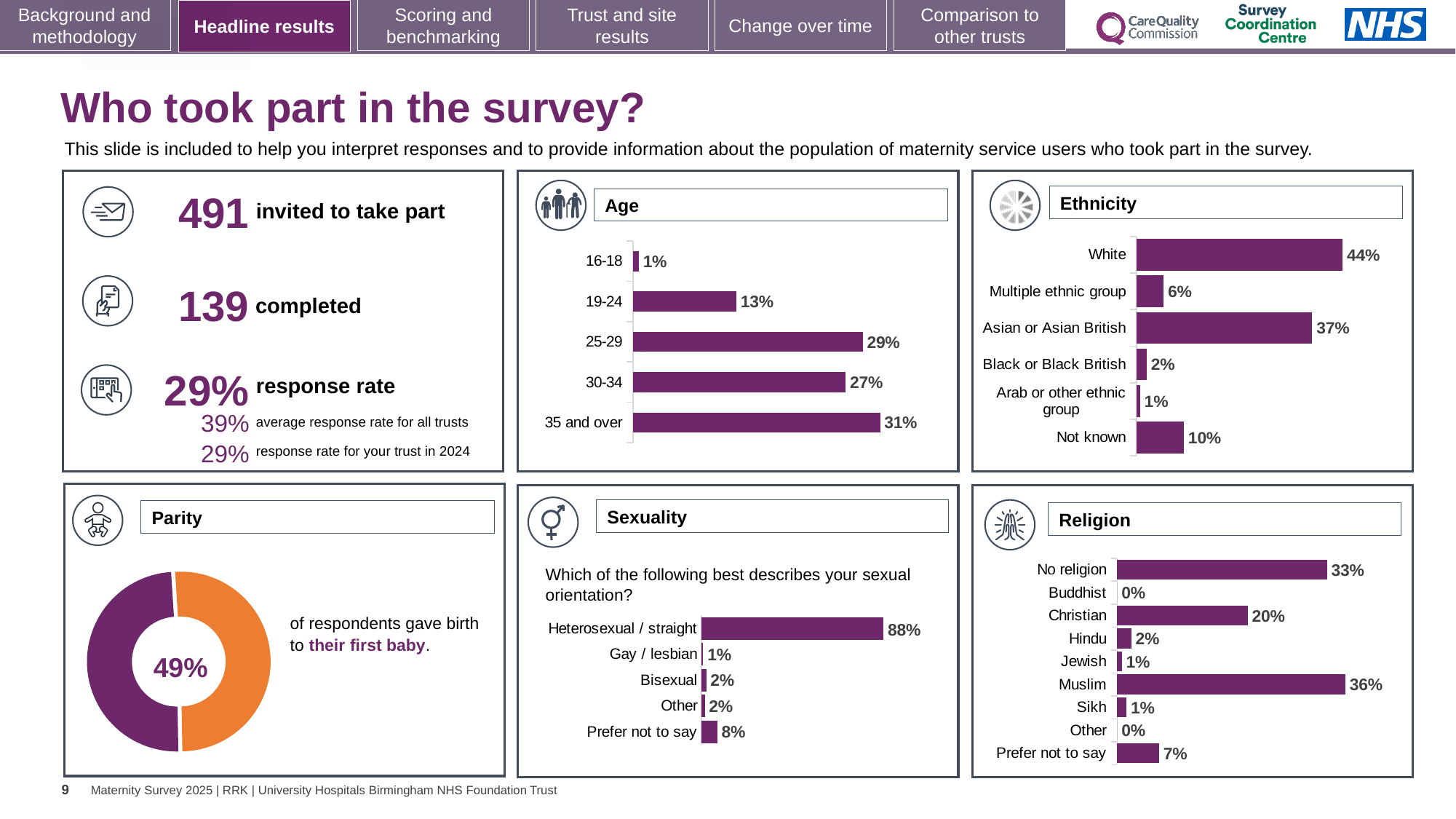
In the Religion chart, what is the value for Christian? 20% In the Religion chart, which religion has the highest percentage? Muslim In the Parity chart, what share of respondents gave birth to their first baby? 49% In the Age chart, what percentage of respondents were aged 25-29? 29% In the Age chart, which age group has the highest percentage? 35 and over In the Ethnicity chart, which category has the highest percentage? White In the Sexuality chart, which is larger, Prefer not to say or Bisexual? Prefer not to say In the Ethnicity chart, what is the difference between White and Asian or Asian British? 7% What kind of chart is the Parity chart? Doughnut chart In the Ethnicity chart, what is the value for Asian or Asian British? 37% In the Sexuality chart, what percentage of respondents answered Heterosexual / straight? 88% In the Religion chart, how many categories are shown? 9